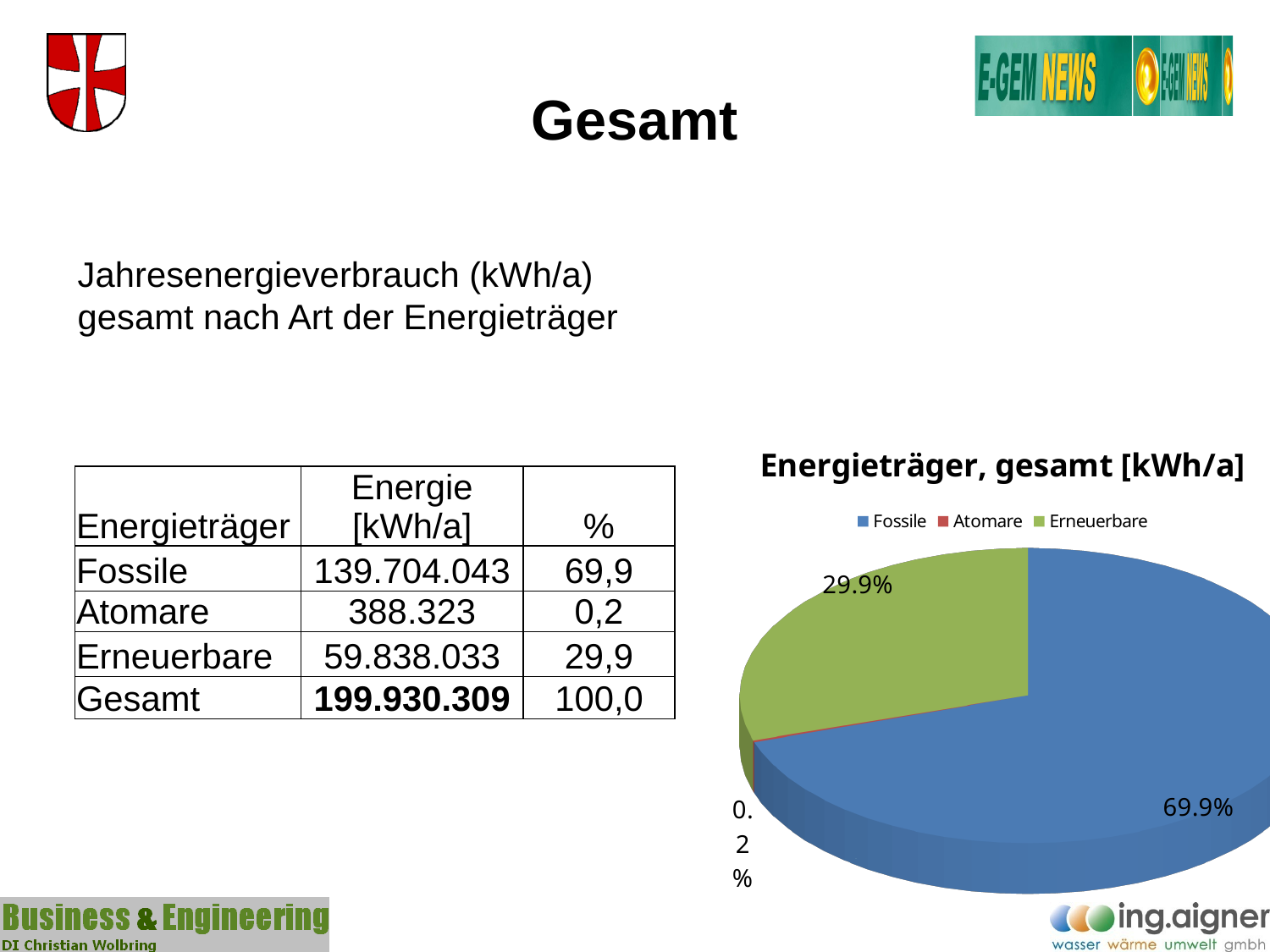
What share of the pie does Atomare have? 0.2% What kind of chart is shown on the slide? pie chart Which is larger in the pie chart, Fossile or Erneuerbare? Fossile Which slice of the pie chart is the smallest? Atomare What is the difference in percentage points between the Fossile and Erneuerbare slices? 40.0 percentage points What is the title of the chart? Energieträger, gesamt [kWh/a] What share of the pie does Erneuerbare have? 29.9% What share of the pie does Fossile have? 69.9% Which colour represents Erneuerbare in the pie chart? green Which slice of the pie chart is the largest? Fossile How many slices does the pie chart have? 3 How many entries does the chart's legend list? 3